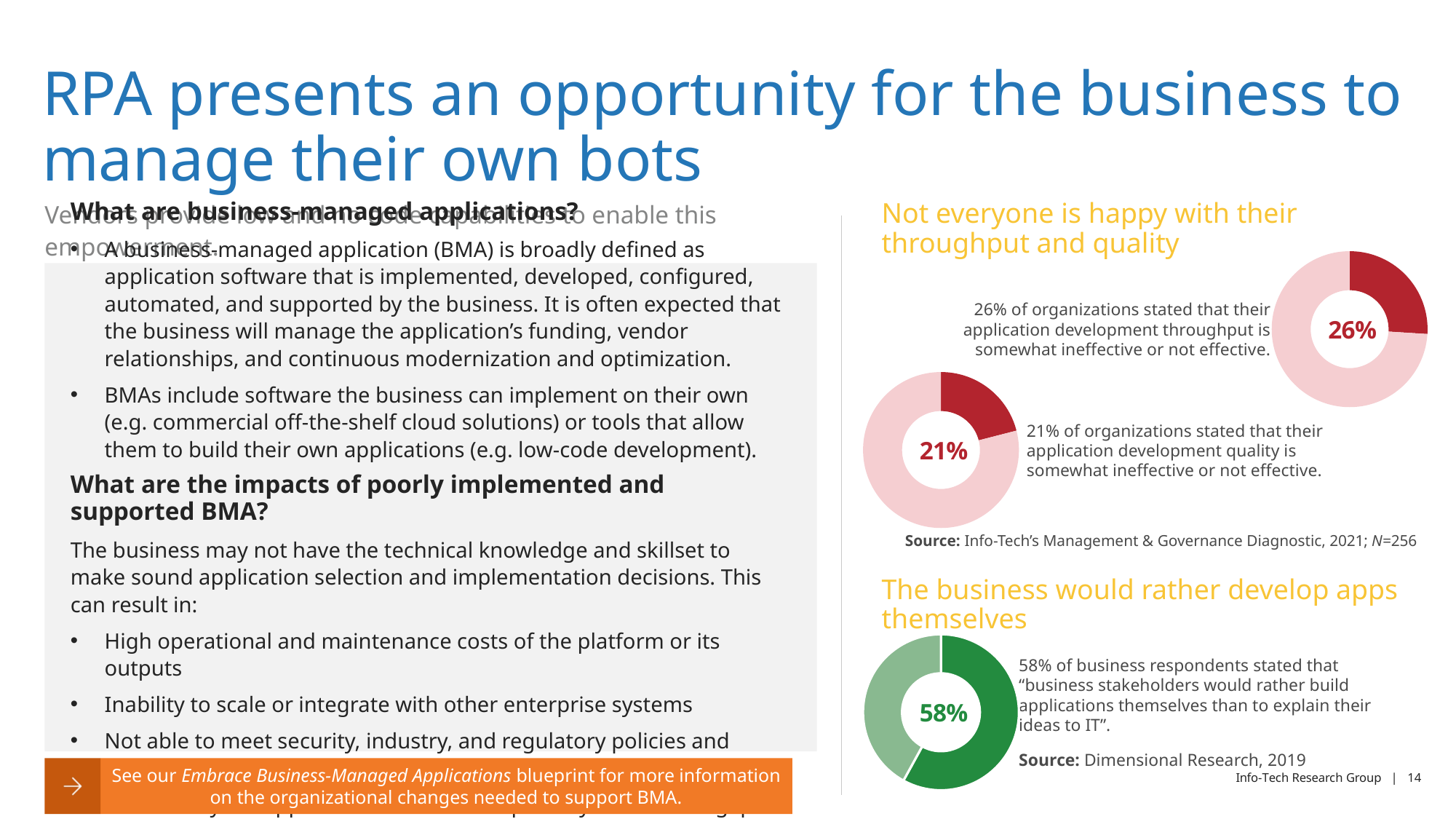
What colour is the highlighted segment in the two donut charts under 'Not everyone is happy with their throughput and quality'? Red What kind of chart is used to show the 26%, 21% and 58% figures on the slide? Donut (pie) chart What value is shown in the centre of the green donut chart under 'The business would rather develop apps themselves'? 58% What value is shown in the centre of the donut chart about application development quality? 21% How many donut charts are shown on the slide? 3 In the green donut chart, what share of business respondents said stakeholders would rather build applications themselves than explain their ideas to IT? 58% Is the highlighted value in the green donut chart greater or less than 50%? greater What value is shown in the centre of the donut chart about application development throughput? 26% What is the difference in percentage points between the throughput donut (26%) and the quality donut (21%)? 5 percentage points Is the highlighted value in the quality donut chart greater or less than 25%? less What is the source cited for the 26% and 21% donut charts? Info-Tech's Management & Governance Diagnostic, 2021; N=256 Which is larger: the share of organizations rating their application development throughput as ineffective, or the share rating their quality as ineffective? Throughput (26%)